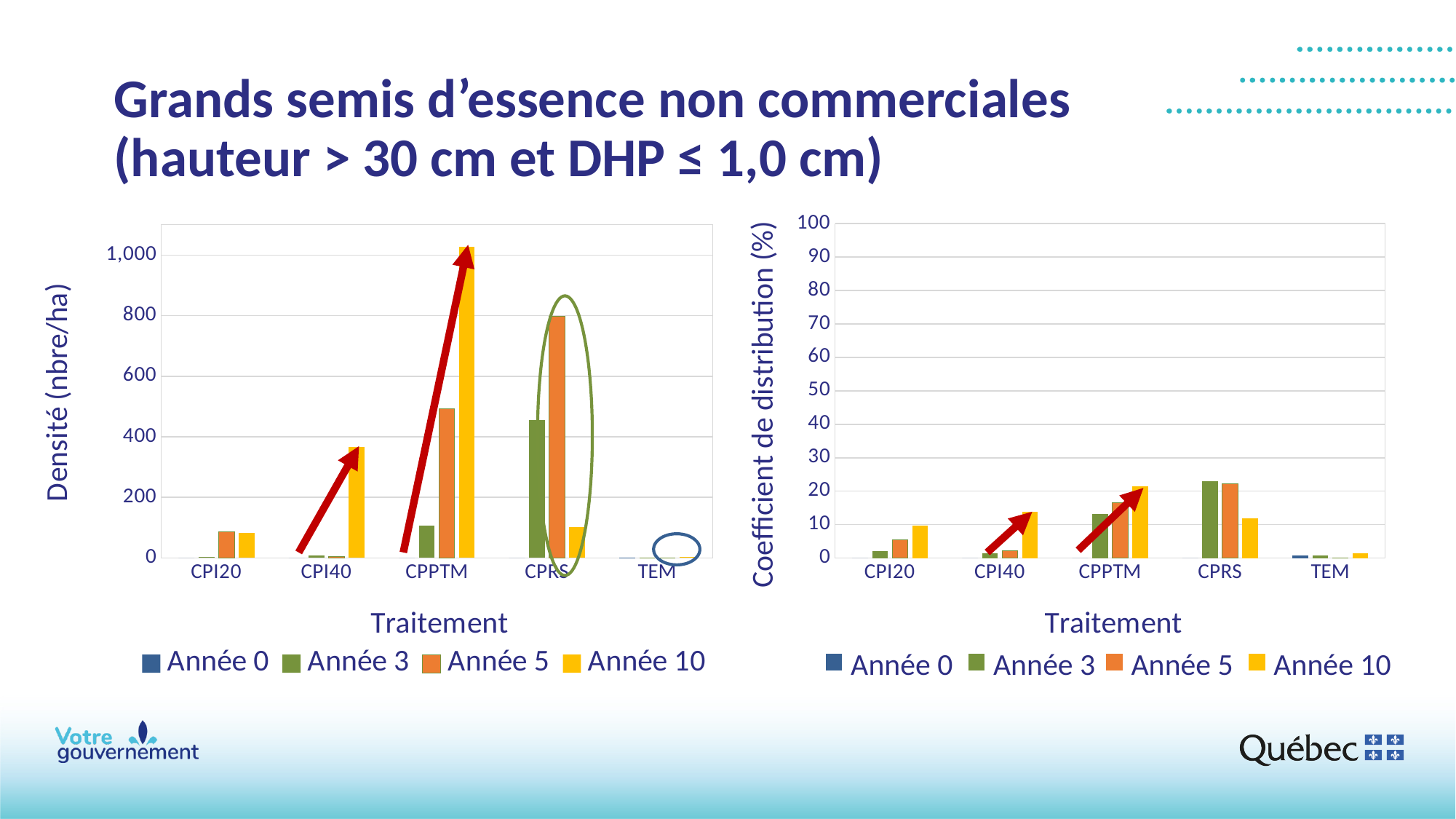
In the left chart (Densité), is the Année 10 value for CPPTM greater or less than 800? greater In the left chart (Densité), which treatment has the highest Année 10 bar? CPPTM In the right chart (Coefficient de distribution), do the values for CPI20 rise or fall from Année 3 to Année 10? rise In the left chart (Densité), which treatment has the lowest Année 10 bar? TEM In the right chart (Coefficient de distribution), is the Année 3 value for CPRS greater or less than 20? greater In the left chart (Densité), is the Année 10 value for CPI40 greater or less than 200? greater What kind of chart is the left chart (Densité)? bar chart How many series does the legend of the right chart (Coefficient de distribution) list? 4 In the left chart (Densité), which is larger for Année 5: CPPTM or CPRS? CPRS In the right chart (Coefficient de distribution), which treatment has the highest Année 3 bar? CPRS How many treatments are shown on the x axis of the left chart (Densité)? 5